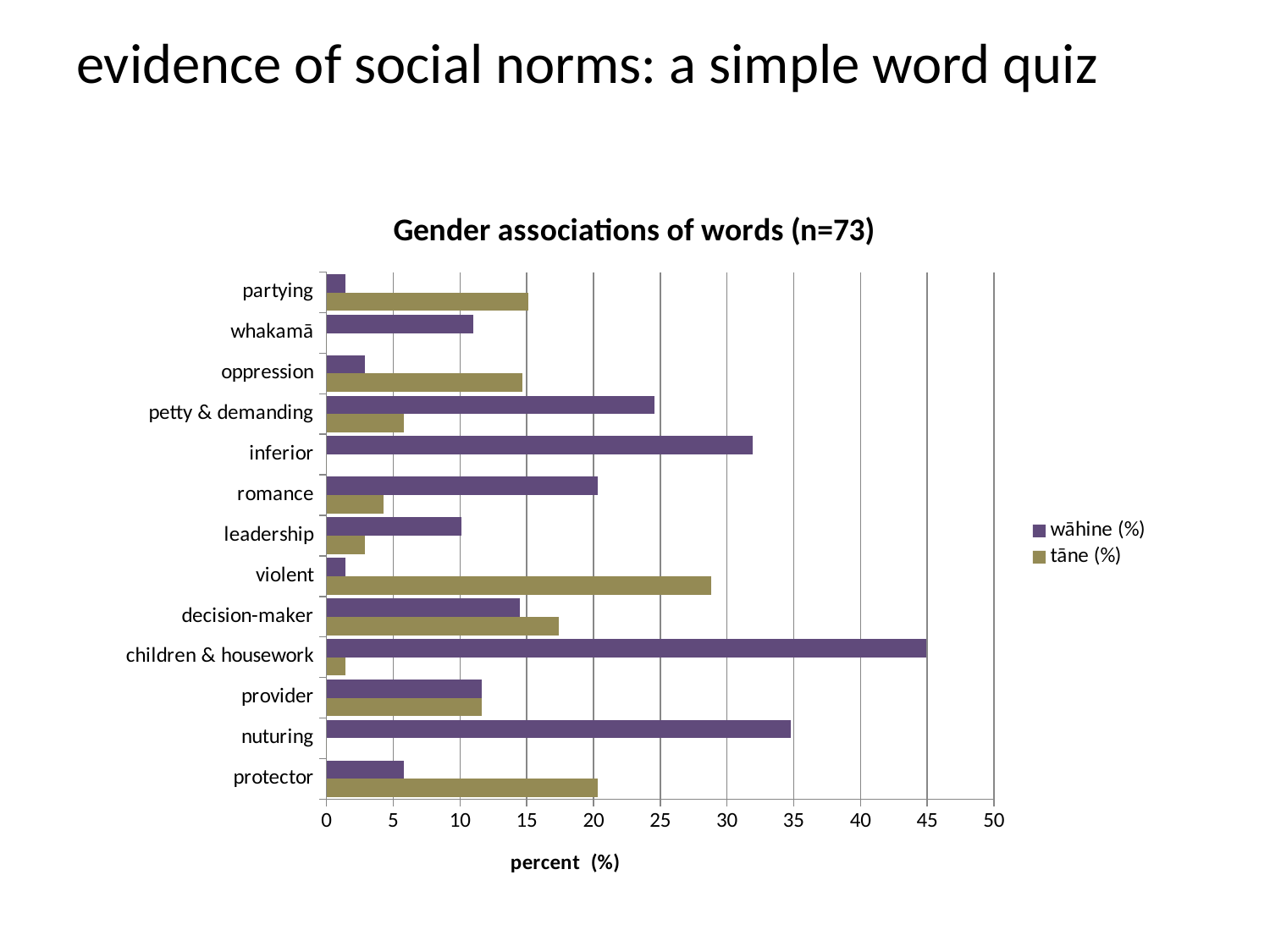
For the word romance, which series has the larger value, wāhine (%) or tāne (%)? wāhine (%) Is the wāhine (%) value for children & housework greater or less than 40? greater Which word has the highest wāhine (%) value? children & housework What kind of chart is shown on the slide? bar chart How many series does the legend list? 2 How many word categories are shown on the chart? 13 Is the tāne (%) value for violent greater or less than 25? greater For the word decision-maker, which series has the larger value, wāhine (%) or tāne (%)? tāne (%) Is the tāne (%) value for protector greater or less than 15? greater What is the title of the chart? Gender associations of words (n=73) Which word has the highest tāne (%) value? violent